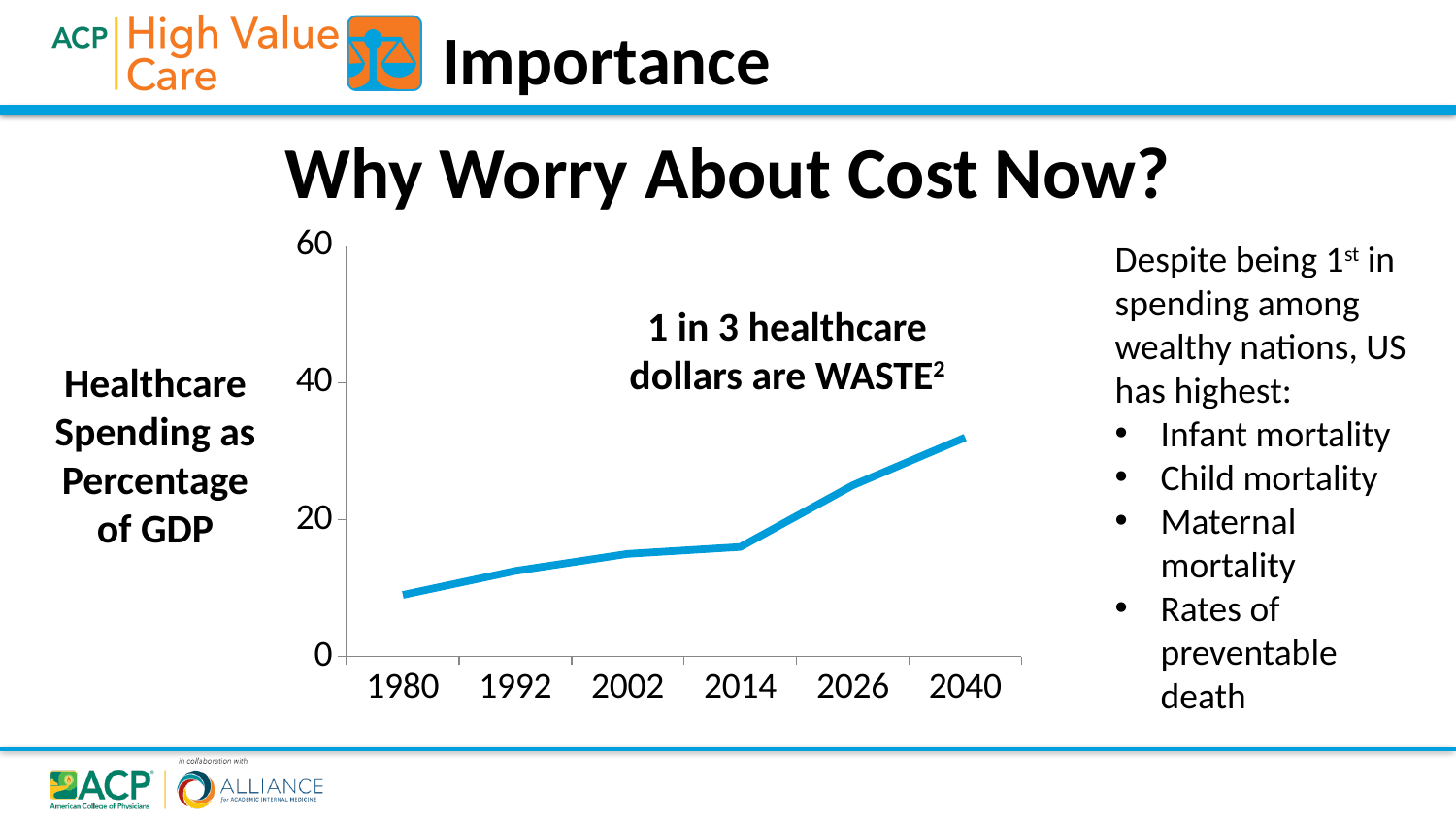
What is the highest tick value shown on the y axis of the chart? 60 How many years are labelled on the x axis of the chart? 6 Is the value for 2026 greater or less than 20? greater Which year has the larger value, 2014 or 2026? 2026 Which year has the lowest healthcare spending as a percentage of GDP in the chart? 1980 What kind of chart is shown on the slide? line chart Which year has the highest healthcare spending as a percentage of GDP in the chart? 2040 Does healthcare spending as a percentage of GDP rise or fall from 1980 to 2040 in the chart? rise Is the value for 1980 greater or less than 20? less Is the value for 2040 greater or less than 20? greater What is the label on the y axis of the chart? Healthcare Spending as Percentage of GDP